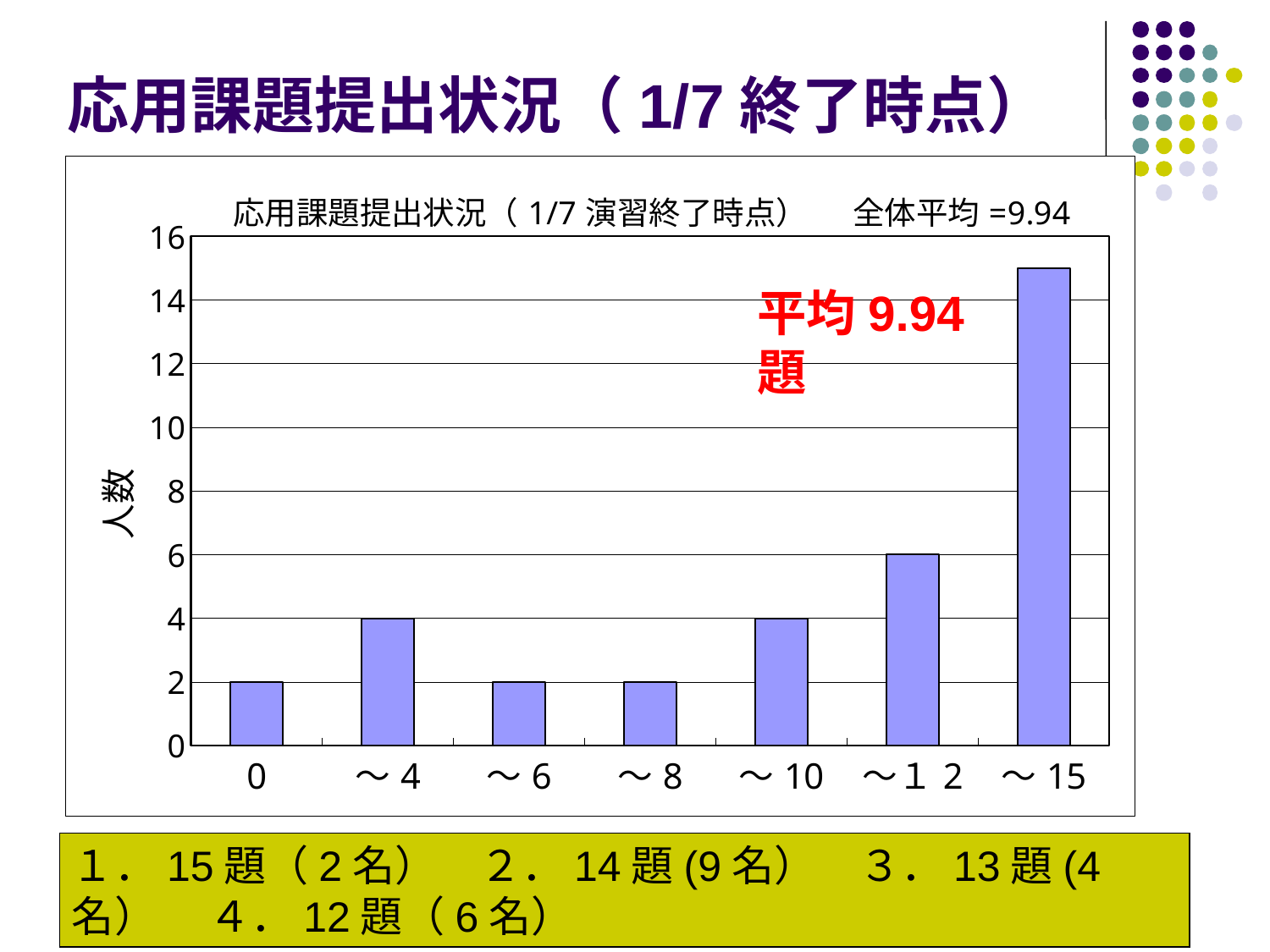
What is the overall average (全体平均) stated in the chart title? 9.94 What is the value (人数) for the category ～12? 6 What is the value (人数) for the category ～4? 4 What is the label of the y axis of the chart? 人数 How many categories are shown on the x axis of the chart? 7 What is the difference between the values for ～12 and ～4? 2 Is the value for ～15 greater or less than 14? greater Which category has the highest value in the chart? ～15 What kind of chart is shown on the slide? bar chart What is the value (人数) for the category 0? 2 What is the value (人数) for the category ～10? 4 Which is larger, the value for ～12 or the value for ～8? ～12